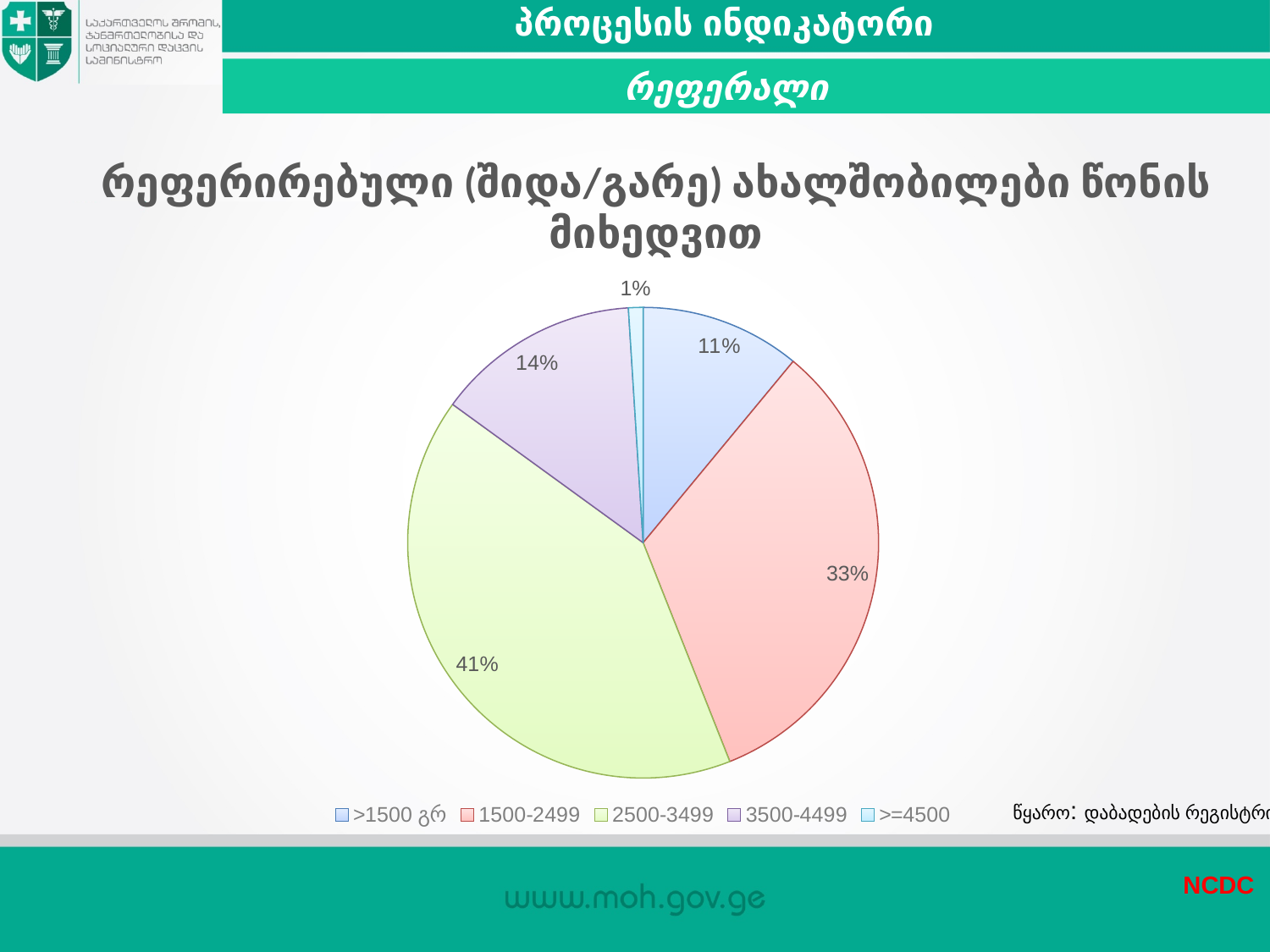
What percentage is shown for the >=4500 category? 1% What is the difference in percentage points between the 2500-3499 and 1500-2499 slices? 8 Which slice is larger: 3500-4499 or >1500 გრ? 3500-4499 How many slices does the pie chart have? 5 What percentage is shown for the 1500-2499 category? 33% Which category has the smallest share of the pie? >=4500 Which category has the largest share of the pie? 2500-3499 What colour is the slice for the 1500-2499 category? pink What percentage is shown for the 2500-3499 category? 41% What type of chart is shown on the slide? pie chart What percentage is shown for the 3500-4499 category? 14% What is the combined share of the 1500-2499 and 2500-3499 slices? 74%